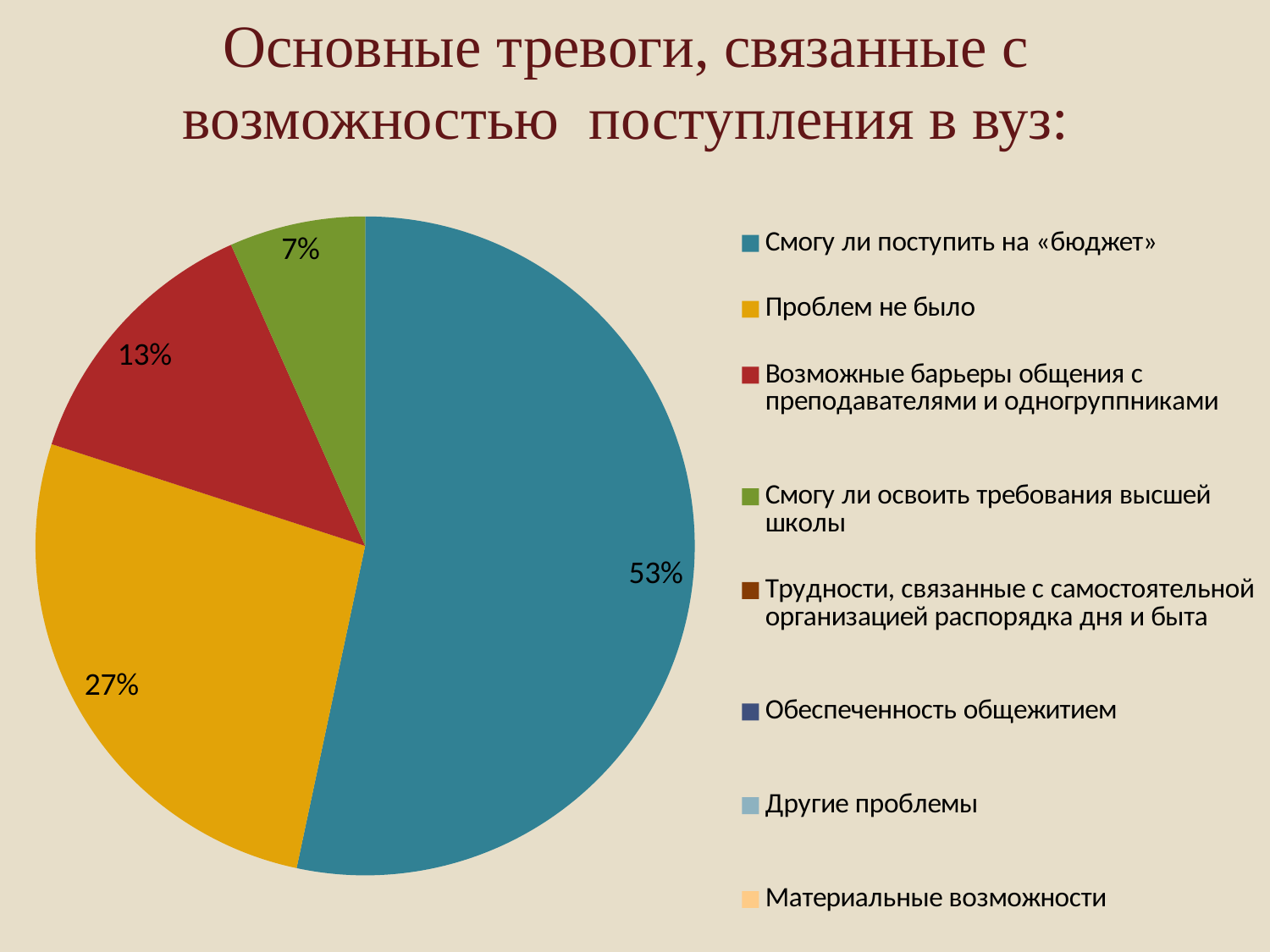
What colour is the slice for «Проблем не было»? Yellow Which labelled slice is the smallest? Смогу ли освоить требования высшей школы What percentage is shown for «Проблем не было»? 27% How many entries does the legend list? 8 How many slices with data labels are visible in the pie? 4 What percentage is shown for «Смогу ли поступить на «бюджет»»? 53% What percentage is shown for «Возможные барьеры общения с преподавателями и одногруппниками»? 13% What is the difference in percentage points between «Смогу ли поступить на «бюджет»» and «Проблем не было»? 26 Which category has the largest slice of the pie? Смогу ли поступить на «бюджет» What type of chart is shown on the slide? Pie chart What percentage is shown for «Смогу ли освоить требования высшей школы»? 7% Which is larger: the slice for «Проблем не было» or the slice for «Возможные барьеры общения с преподавателями и одногруппниками»? Проблем не было